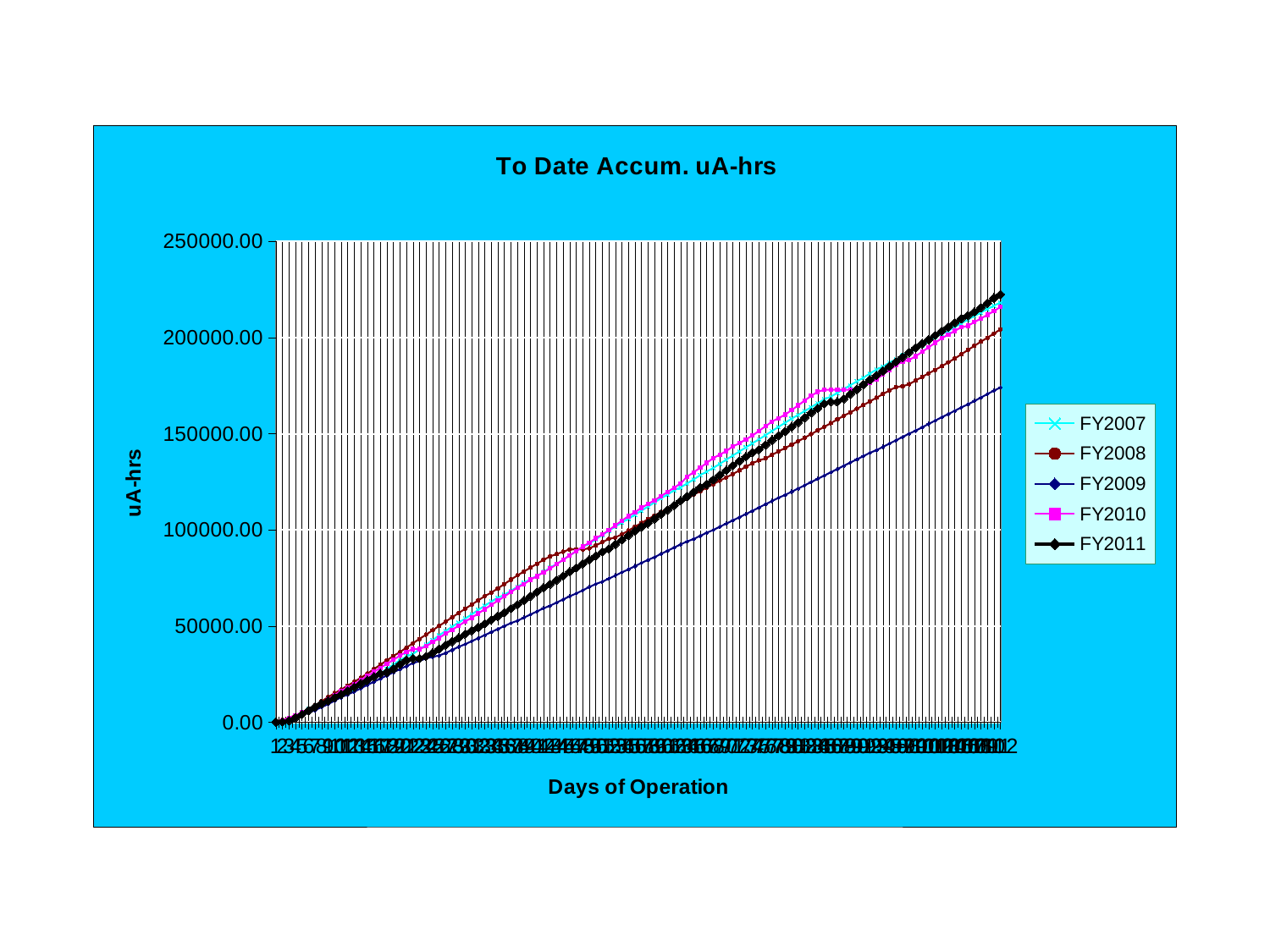
At the right end of the chart, which is larger, the value for FY2008 or the value for FY2009? FY2008 Is the final value for FY2009 greater or less than 200000.00? less Do the values for FY2009 rise or fall along the x axis? rise Is the final value for FY2009 greater or less than 150000.00? greater What is the label of the x axis? Days of Operation How many series does the legend list? 5 Is the final value for FY2011 greater or less than 200000.00? greater Do the values for FY2011 rise or fall as the days of operation increase? rise At the right end of the chart, which is larger, the value for FY2011 or the value for FY2009? FY2011 What is the title of the chart? To Date Accum. uA-hrs Which series ends at the lowest value at the right end of the chart? FY2009 What kind of chart is shown on the slide? line chart